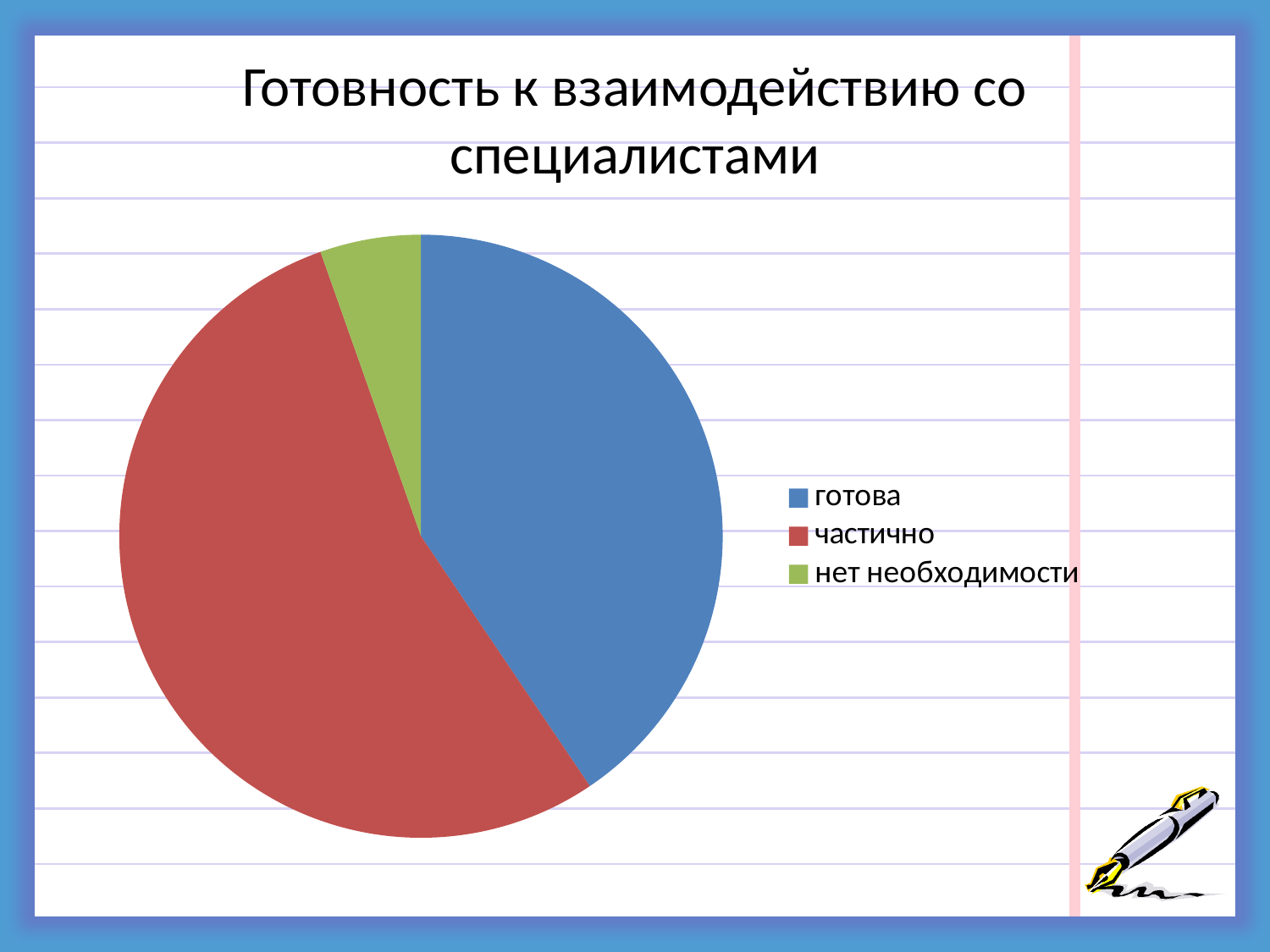
How many slices does the pie chart have? 3 Which category has the smallest slice of the pie chart? нет необходимости What colour is the slice for готова in the pie chart? blue Which slice is larger: частично or нет необходимости? частично Which category has the largest slice of the pie chart? частично What kind of chart is shown on the slide? pie chart Which slice is larger: частично or готова? частично How many entries does the legend of the pie chart list? 3 Which slice is larger: готова or нет необходимости? готова What is the title of the chart? Готовность к взаимодействию со специалистами